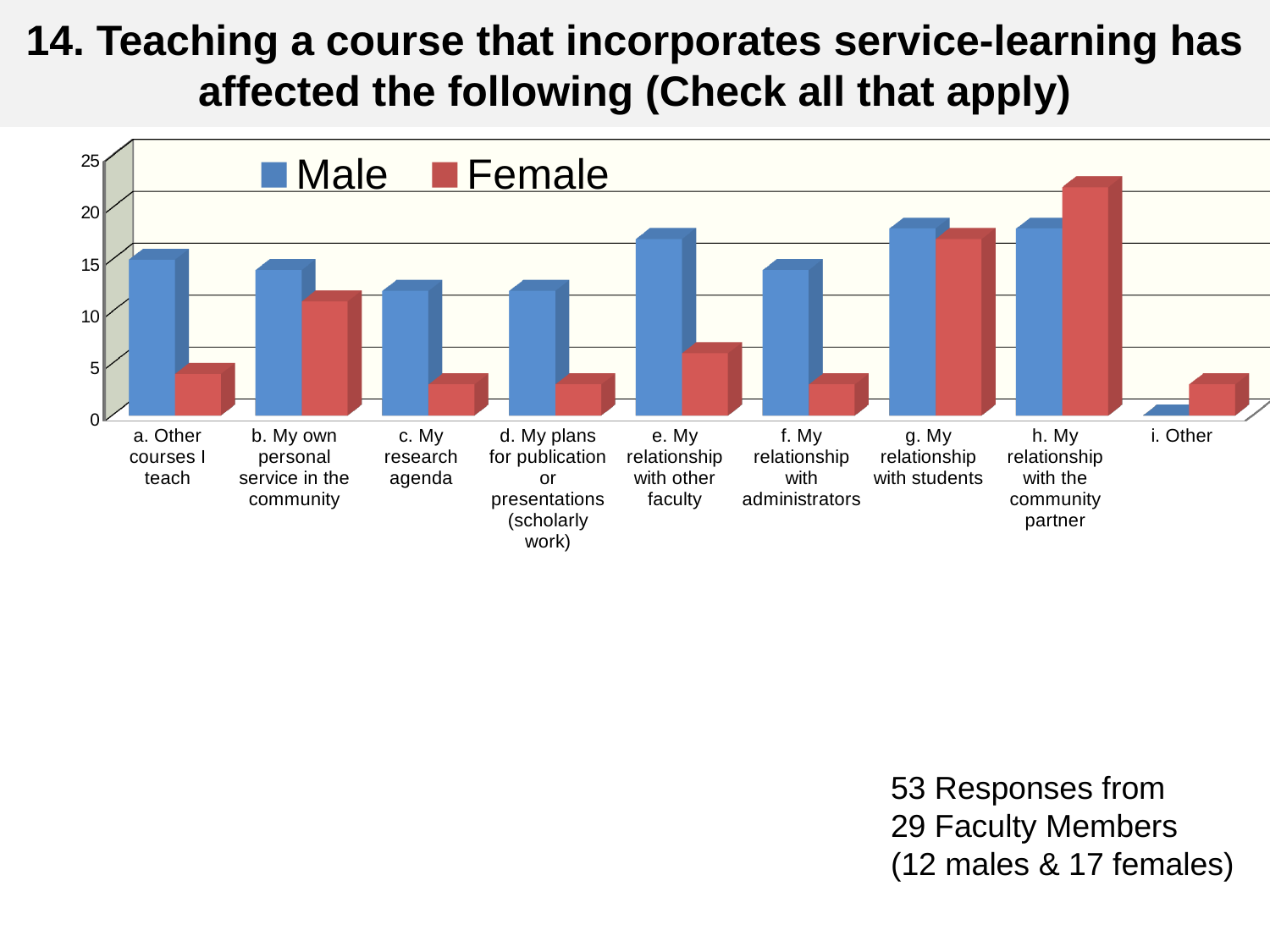
How many categories are shown along the x axis? 9 Is the Male value for 'a. Other courses I teach' greater or less than 10? greater Is the Female value for 'h. My relationship with the community partner' greater or less than 20? greater Which category has the highest Female value? h. My relationship with the community partner For 'a. Other courses I teach', which is larger, the Male value or the Female value? Male Which category has the lowest Male value? i. Other What kind of chart is shown on the slide? bar chart Is the Male value for 'i. Other' greater or less than 5? less Which series is shown in blue? Male For 'h. My relationship with the community partner', which is larger, the Male value or the Female value? Female How many series does the legend list? 2